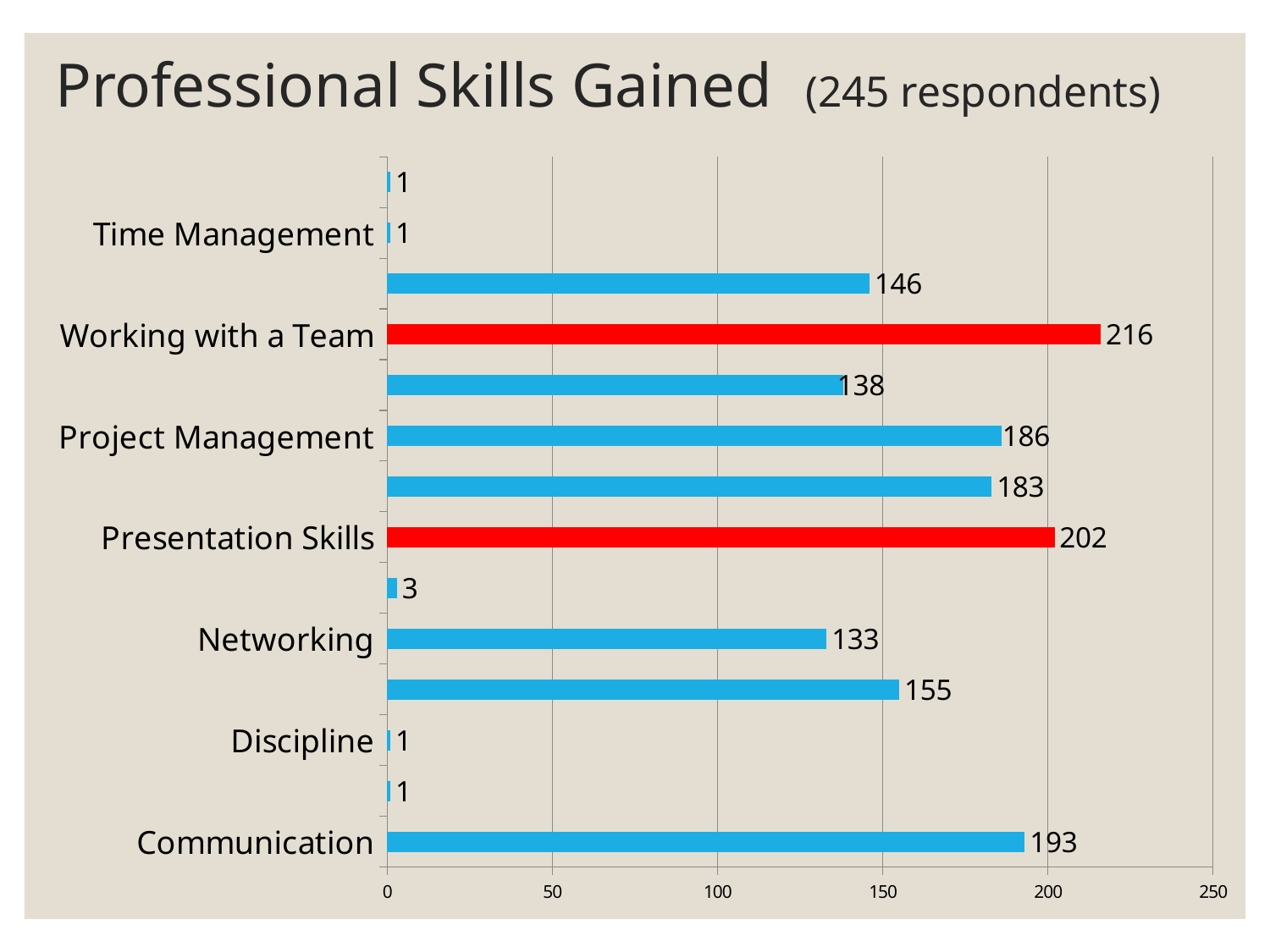
What is the value for Project Management? 186 Which is larger, the value for Communication or the value for Project Management? Communication What is the value for Networking? 133 What kind of chart is shown on the slide? bar chart Is the value for Networking greater or less than 150? less What is the value for Presentation Skills? 202 Which two bars are coloured red? Working with a Team and Presentation Skills What is the value for Working with a Team? 216 What is the value for Communication? 193 What is the difference between the values for Working with a Team and Presentation Skills? 14 Which category has the highest value? Working with a Team What is the title of the chart? Professional Skills Gained